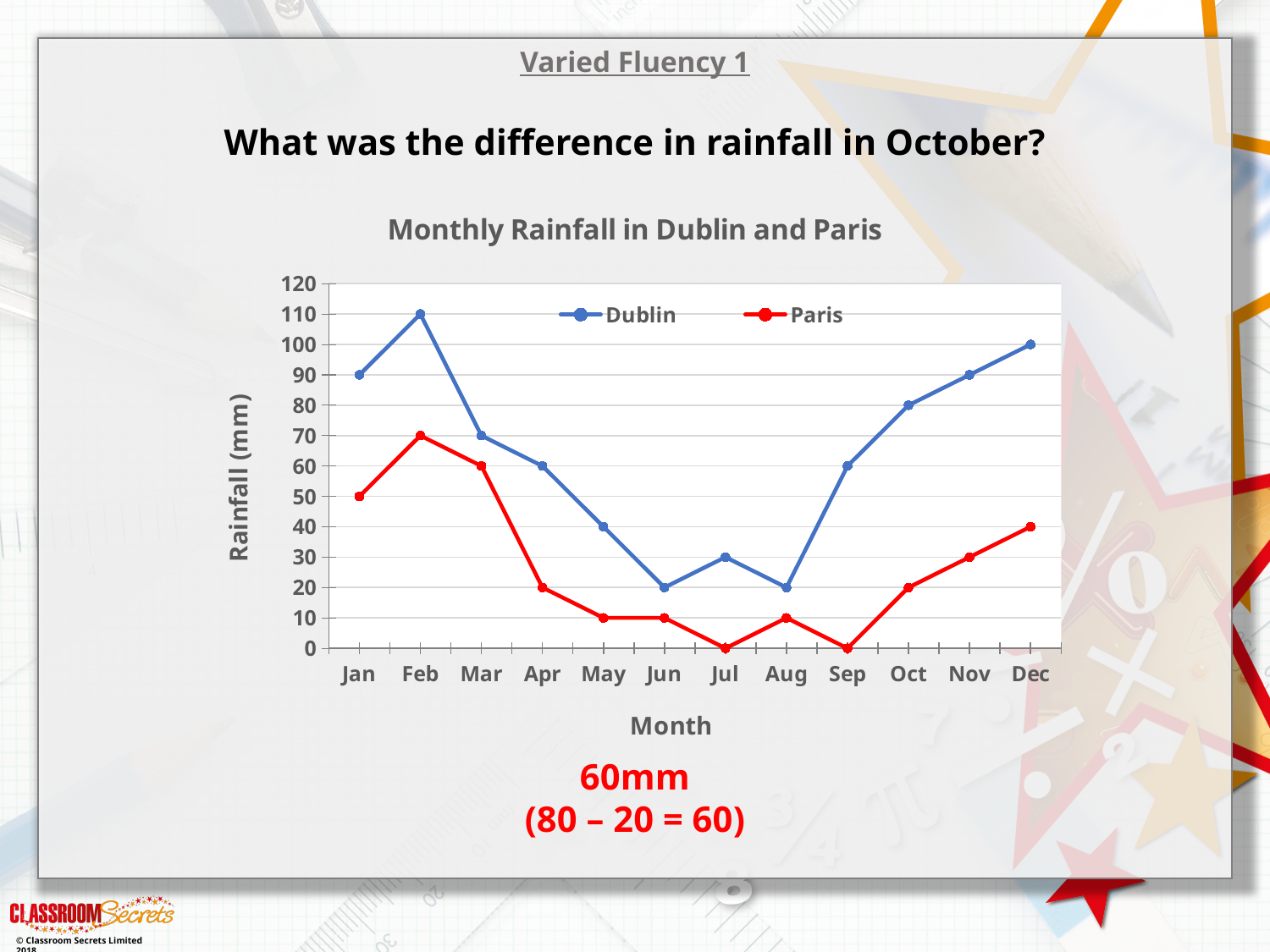
Which city had more rainfall in September, Dublin or Paris? Dublin How many months are plotted along the x axis? 12 What was the rainfall in Paris in October? 20 What was the difference in rainfall between Dublin and Paris in October? 60mm What is the title of the chart? Monthly Rainfall in Dublin and Paris What was the rainfall in Paris in February? 70 What type of chart is shown on the slide? line chart What was the rainfall in Dublin in October? 80 Does Dublin's rainfall rise or fall from September to December? rise How many series does the legend list? 2 In which month was Dublin's rainfall highest? Feb Is the value for Dublin in December greater or less than 90? greater